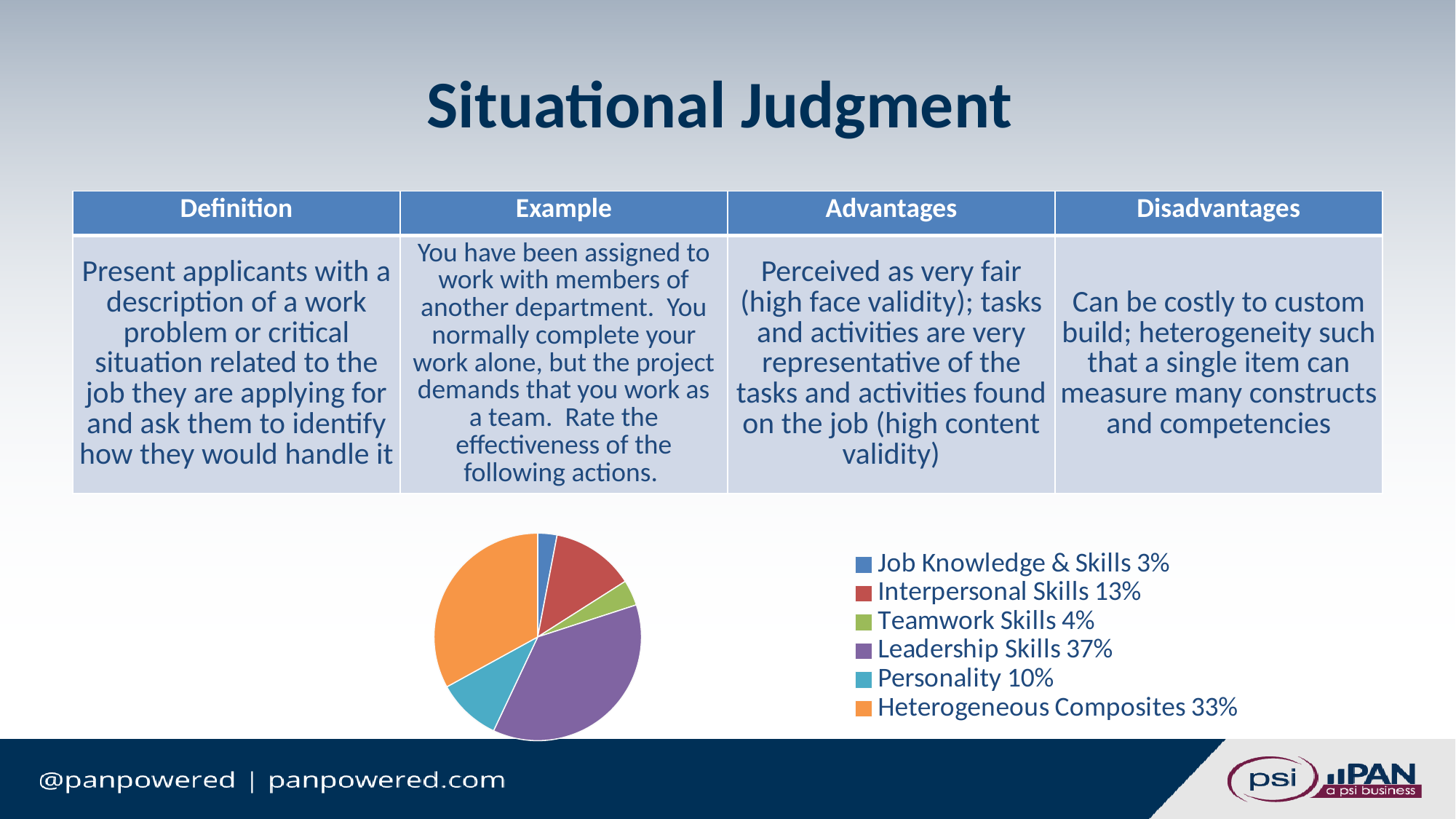
Which category has the smallest slice of the pie? Job Knowledge & Skills What kind of chart is shown on the slide? pie chart Which category has the largest slice of the pie? Leadership Skills What share of the pie does Leadership Skills represent? 37% What is the difference between Leadership Skills and Heterogeneous Composites? 4% What colour is the slice for Heterogeneous Composites? orange What is the difference between Interpersonal Skills and Personality? 3% What share of the pie does Heterogeneous Composites represent? 33% What is the value for Interpersonal Skills? 13% Which is larger, Teamwork Skills or Personality? Personality What is the value for Personality? 10% How many categories does the pie chart have? 6